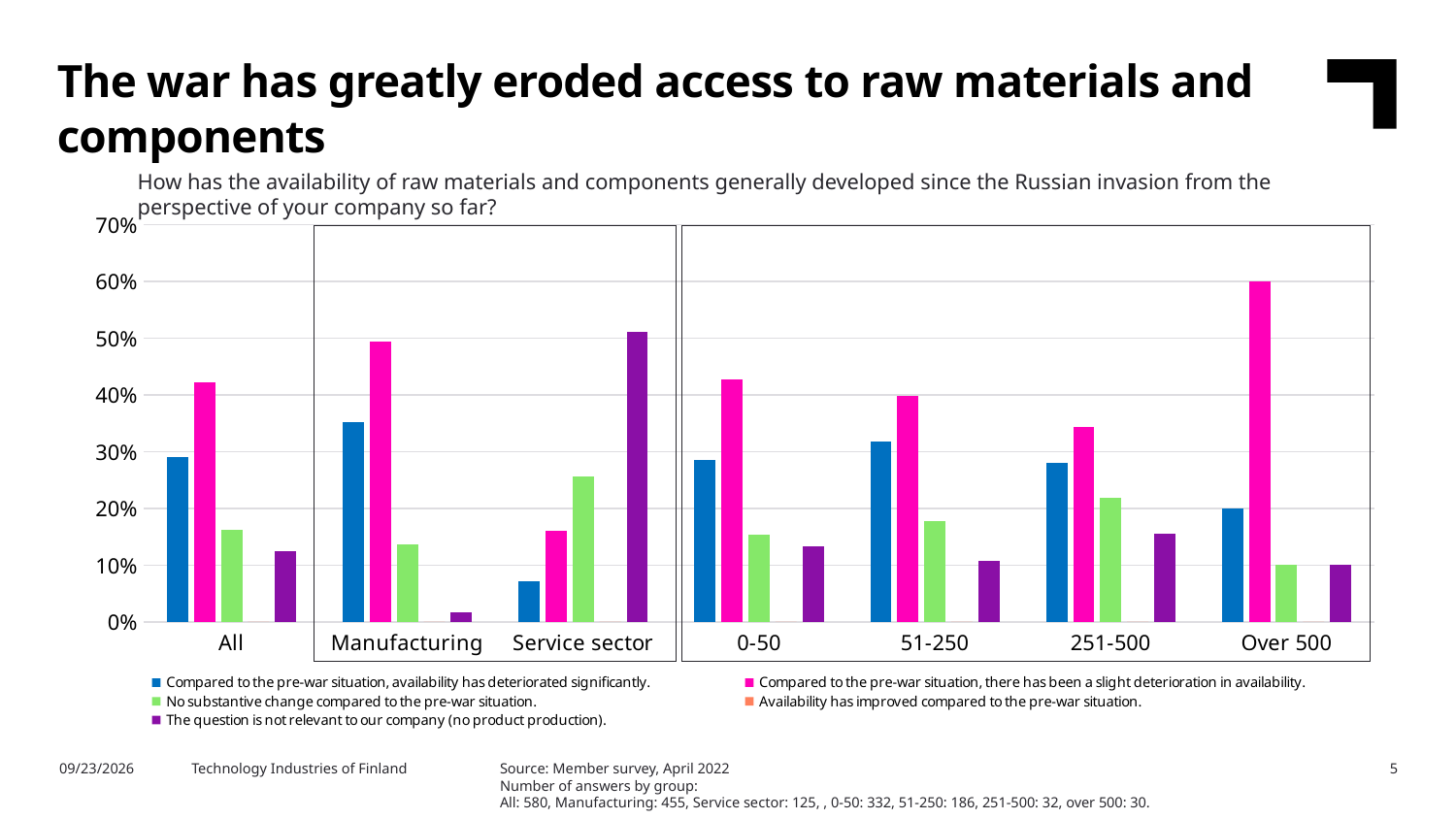
How many categories are shown along the x axis of the chart? 7 In the All category, which is larger: 'availability has deteriorated significantly' or 'slight deterioration in availability'? Slight deterioration in availability How many series does the chart's legend list? 5 Is the value for 'availability has deteriorated significantly' in the Manufacturing category greater or less than 30%? greater Is the value for 'availability has deteriorated significantly' in the Over 500 category greater or less than 30%? less Which category has the highest bar for 'No substantive change compared to the pre-war situation'? Service sector Is the value for 'slight deterioration in availability' in the Over 500 category greater or less than 50%? greater In the Service sector category, which is larger: 'The question is not relevant to our company' or 'availability has deteriorated significantly'? The question is not relevant to our company Which category has the lowest bar for 'Compared to the pre-war situation, availability has deteriorated significantly'? Service sector What kind of chart is shown on the slide? Bar chart Which category has the highest bar for 'Compared to the pre-war situation, there has been a slight deterioration in availability'? Over 500